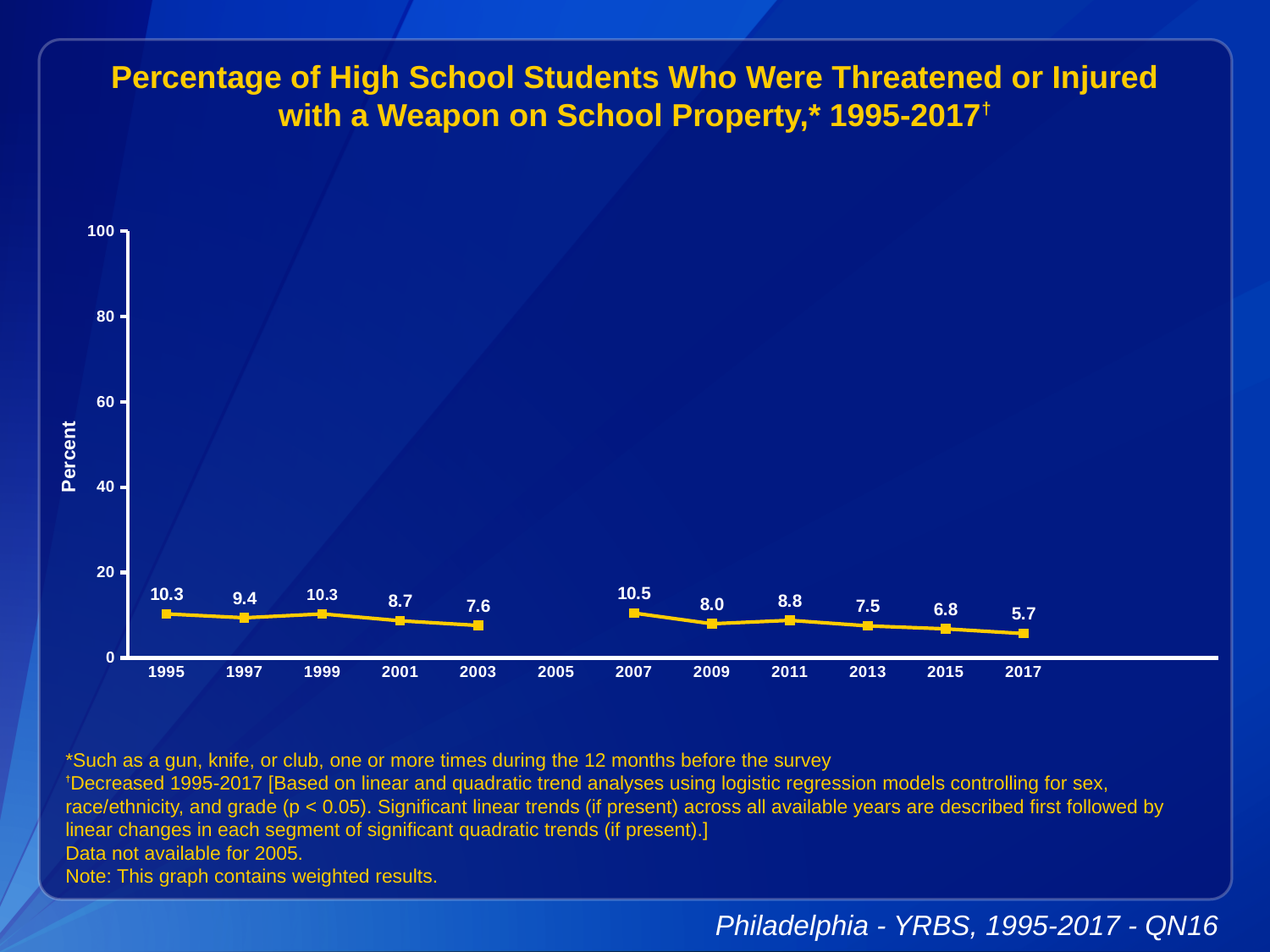
Is the value for 2007 greater or less than 20? less What is the value for 2009? 8.0 Do the values generally rise or fall from 1995 to 2017? fall What is the value for 1995? 10.3 What is the value for 2017? 5.7 What is the difference between the values for 1995 and 2017? 4.6 Which year has the highest value? 2007 Which is larger, the value for 2011 or the value for 2013? 2011 Which year has the lowest value? 2017 What kind of chart is shown? line chart What is the label on the y axis? Percent How many data points are plotted on the chart? 11